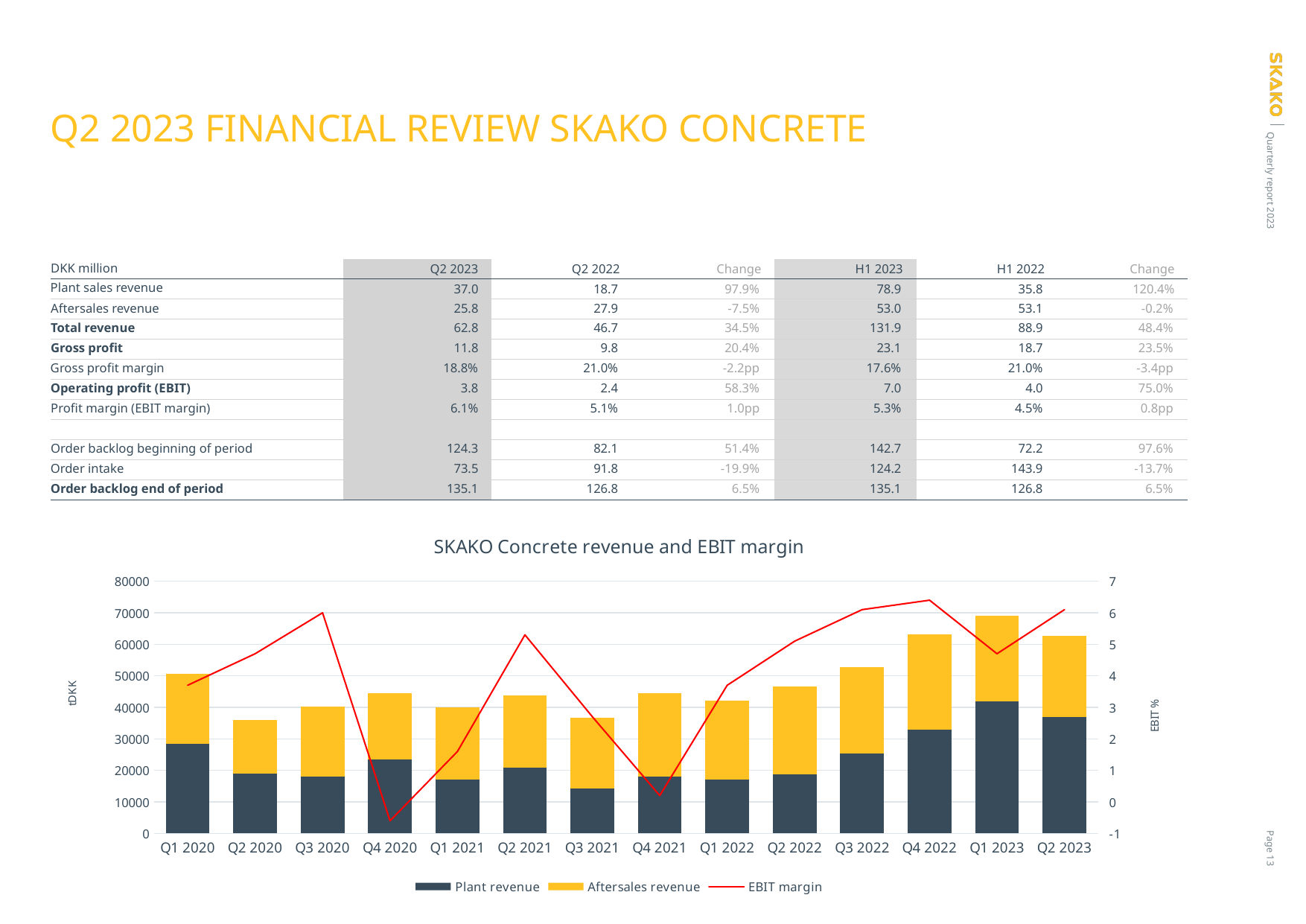
In the 'SKAKO Concrete revenue and EBIT margin' chart, which quarter has the larger plant revenue, Q1 2022 or Q4 2022? Q4 2022 What kind of chart is 'SKAKO Concrete revenue and EBIT margin'? A stacked bar chart with a line In the 'SKAKO Concrete revenue and EBIT margin' chart, is the total revenue bar for Q2 2020 greater or less than 40000 tDKK? less In the 'SKAKO Concrete revenue and EBIT margin' chart, which colour represents aftersales revenue? Yellow In the 'SKAKO Concrete revenue and EBIT margin' chart, is the total revenue bar for Q1 2023 greater or less than 60000 tDKK? greater In the 'SKAKO Concrete revenue and EBIT margin' chart, is the EBIT margin for Q4 2020 greater or less than 0%? less In the 'SKAKO Concrete revenue and EBIT margin' chart, does the EBIT margin rise or fall from Q4 2021 to Q4 2022? rise In the 'SKAKO Concrete revenue and EBIT margin' chart, which quarter has the tallest total revenue bar? Q1 2023 How many quarters are shown on the x axis of the 'SKAKO Concrete revenue and EBIT margin' chart? 14 How many series does the legend of the 'SKAKO Concrete revenue and EBIT margin' chart list? 3 In the 'SKAKO Concrete revenue and EBIT margin' chart, which quarter has the lowest EBIT margin? Q4 2020